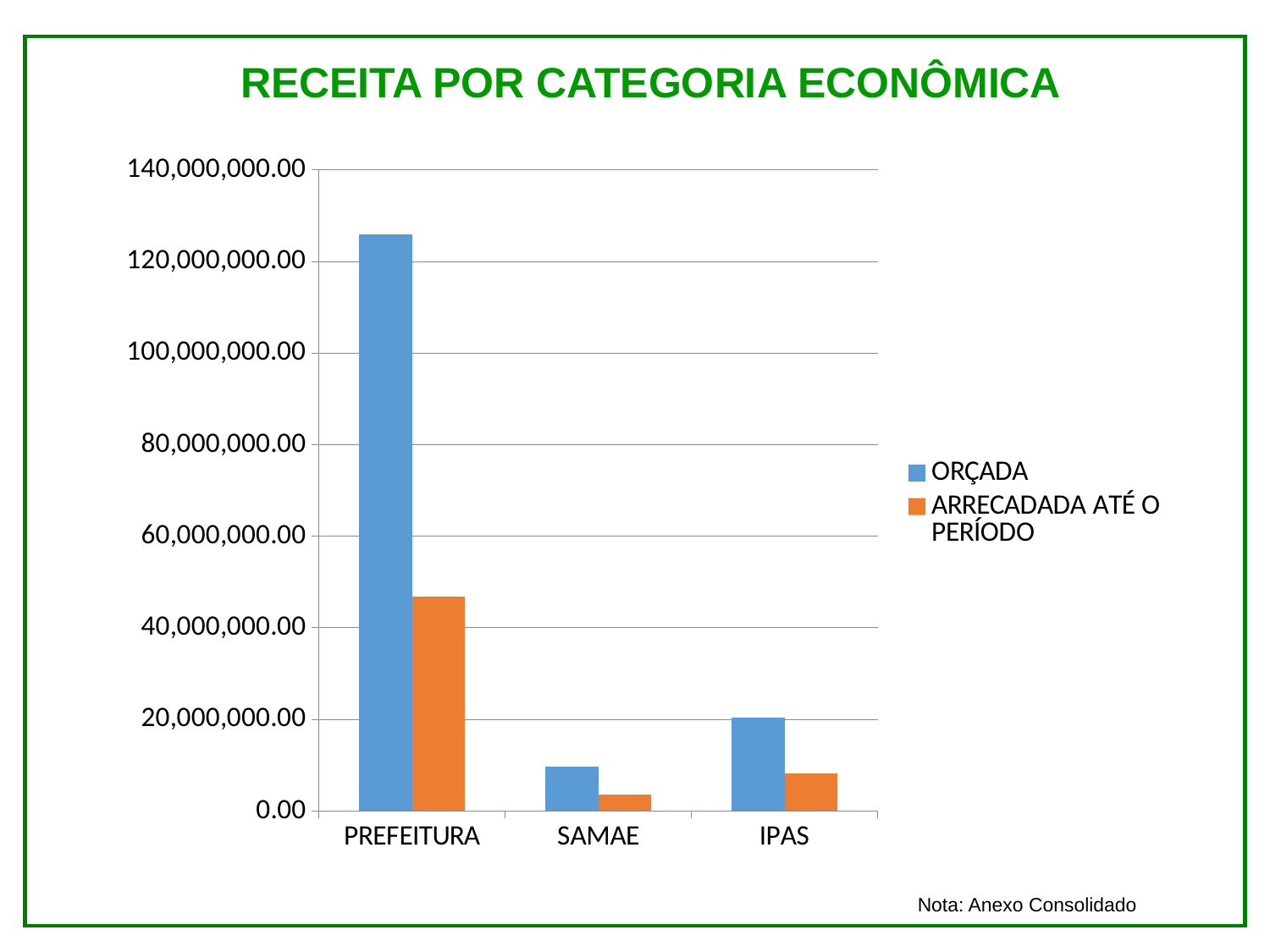
Which has the larger ORÇADA value: SAMAE or IPAS? IPAS What kind of chart is shown on the slide? bar chart Is the ORÇADA value for PREFEITURA greater or less than 120,000,000.00? greater Which category has the lowest ARRECADADA ATÉ O PERÍODO value? SAMAE Which category has the highest ORÇADA value? PREFEITURA Which category has the lowest ORÇADA value? SAMAE How many series does the legend list? 2 Is the ARRECADADA ATÉ O PERÍODO value for PREFEITURA greater or less than 40,000,000.00? greater How many categories are shown on the x axis? 3 Is the ORÇADA value for IPAS greater or less than 40,000,000.00? less For PREFEITURA, which is larger: ORÇADA or ARRECADADA ATÉ O PERÍODO? ORÇADA What is the title of the chart? RECEITA POR CATEGORIA ECONÔMICA